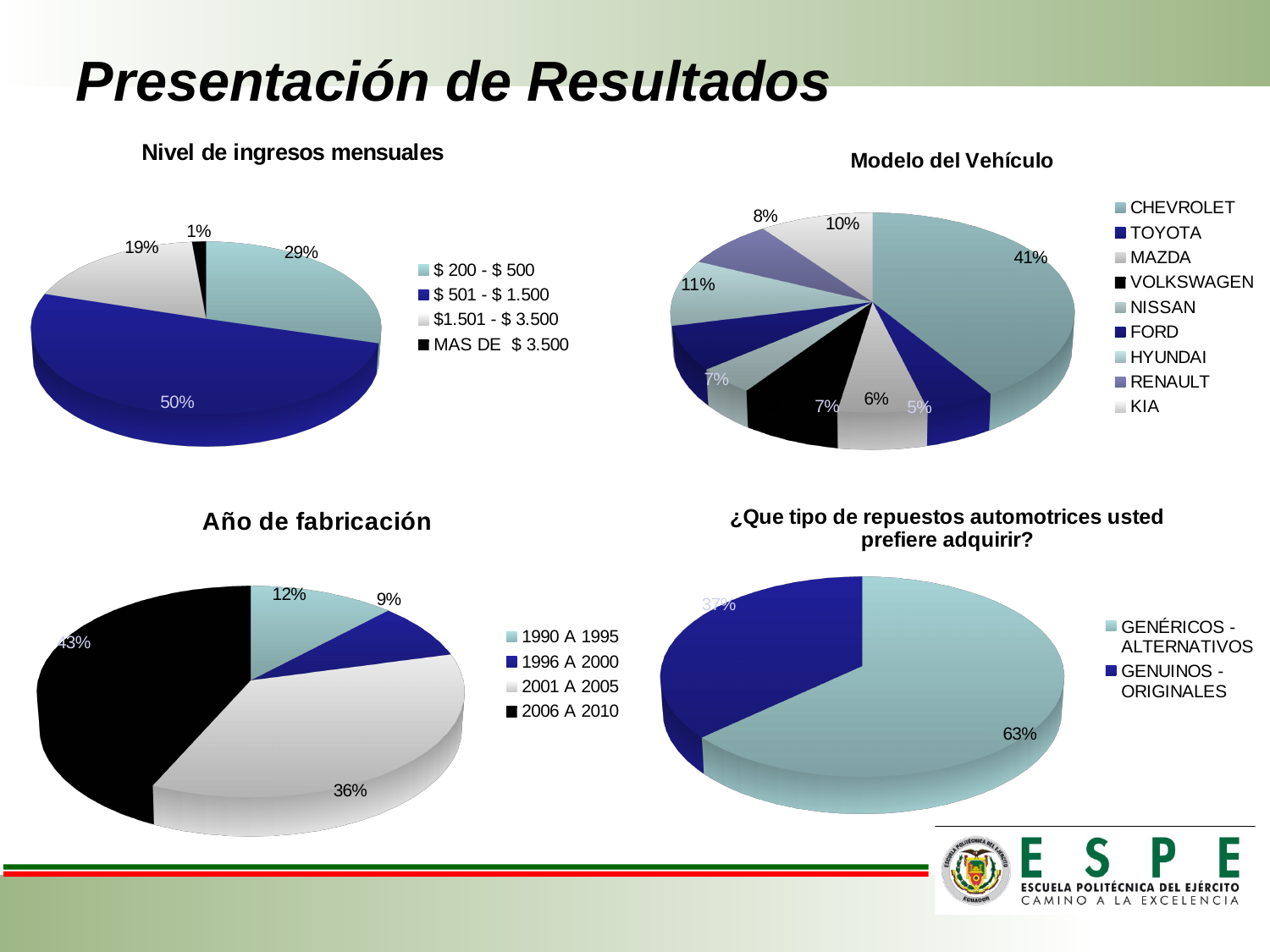
In the 'Modelo del Vehículo' chart, what share is shown for CHEVROLET? 41% In the 'Modelo del Vehículo' chart, which vehicle model has the largest share? CHEVROLET In the 'Nivel de ingresos mensuales' chart, what share is shown for '$ 501 - $ 1.500'? 50% What kind of chart is the 'Año de fabricación' chart? Pie chart How many entries does the legend of the 'Modelo del Vehículo' chart list? 9 In the 'Año de fabricación' chart, which is larger: the share for '1990 A 1995' or the share for '1996 A 2000'? 1990 A 1995 In the '¿Que tipo de repuestos automotrices usted prefiere adquirir?' chart, what share is shown for 'GENUINOS - ORIGINALES'? 37% In the 'Año de fabricación' chart, what is the difference between the '2006 A 2010' share and the '2001 A 2005' share? 7% In the 'Año de fabricación' chart, what share is shown for '2006 A 2010'? 43% In the 'Modelo del Vehículo' chart, what share is shown for KIA? 10% In the 'Nivel de ingresos mensuales' chart, what is the difference between the '$ 200 - $ 500' share and the '$1.501 - $ 3.500' share? 10% In the 'Nivel de ingresos mensuales' chart, which category has the smallest share? MAS DE $ 3.500